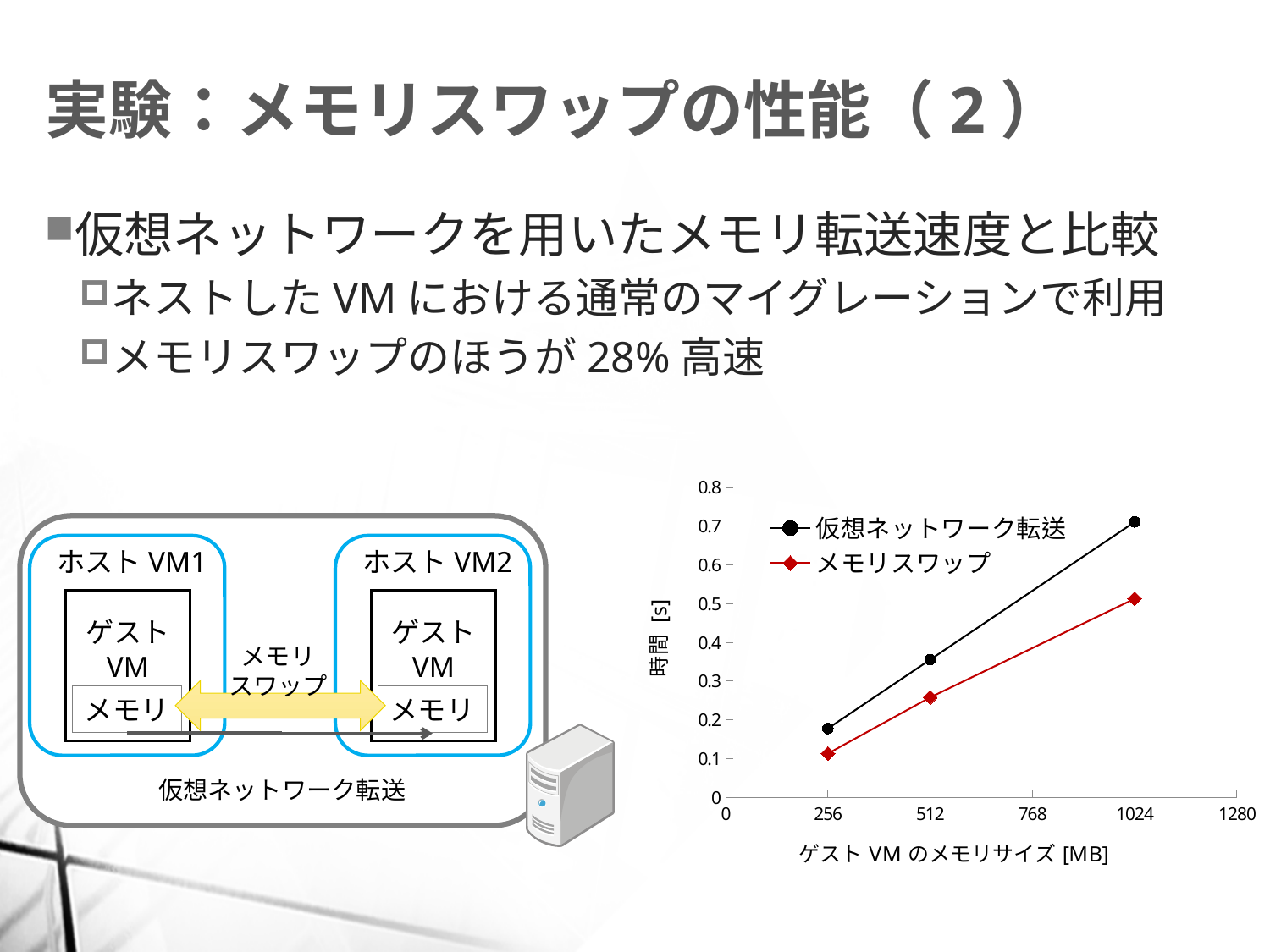
Which series reaches the highest time value on the chart? 仮想ネットワーク転送 Is the value for メモリスワップ at 1024 MB greater or less than 0.6? less What kind of chart is shown on the slide? line chart Does the time for 仮想ネットワーク転送 rise or fall as the guest VM memory size increases? rise Is the value for 仮想ネットワーク転送 at 1024 MB greater or less than 0.6? greater How many series does the chart's legend list? 2 At a memory size of 1024 MB, which series has the larger time: 仮想ネットワーク転送 or メモリスワップ? 仮想ネットワーク転送 How many data points are plotted for the メモリスワップ series? 3 What is the label of the chart's x axis? ゲスト VM のメモリサイズ [MB] What is the label of the chart's y axis? 時間 [s] Is the value for メモリスワップ at 256 MB greater or less than 0.2? less